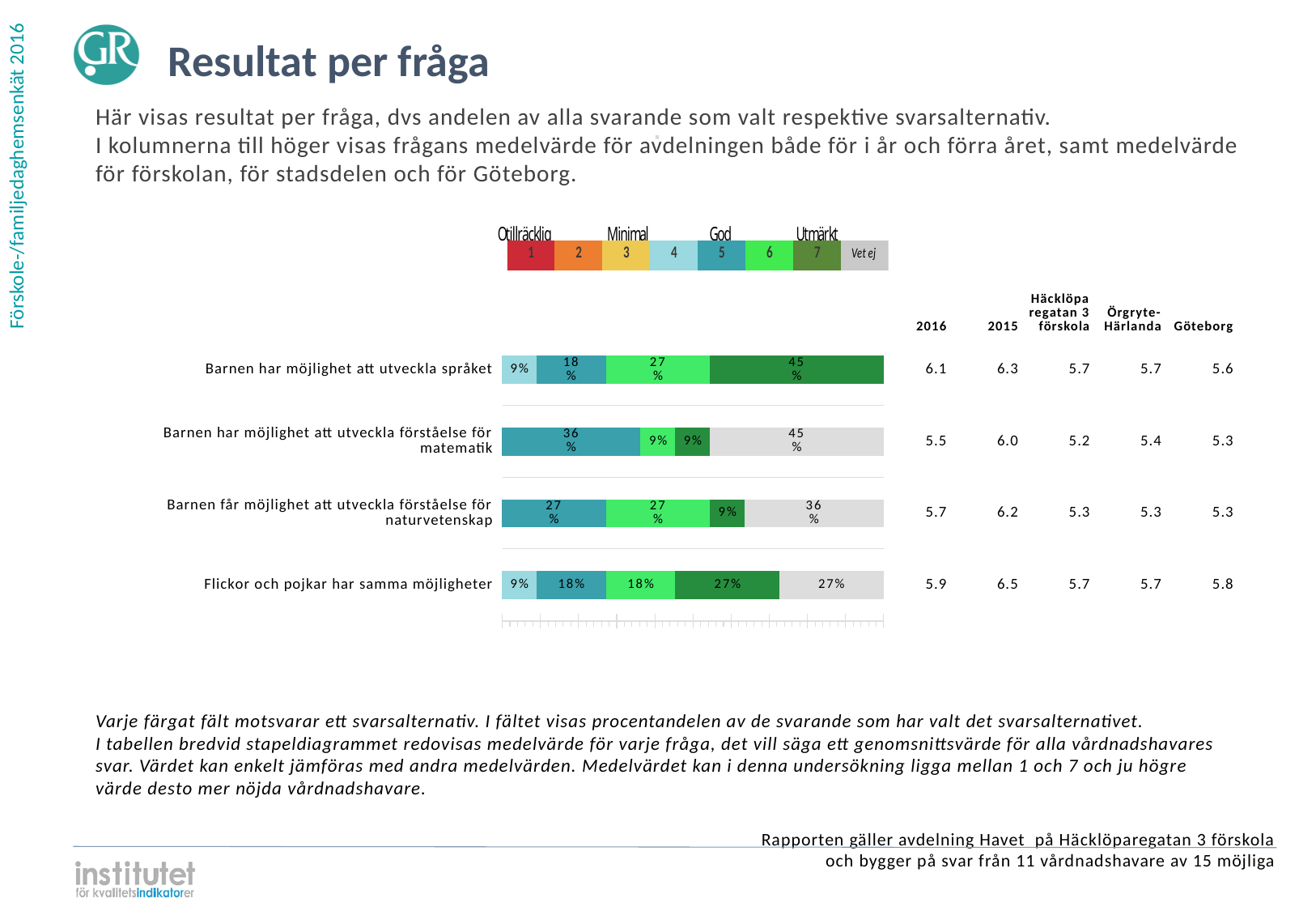
How many answer alternatives does the legend above the chart list? 8 Which is larger: the share choosing 5 for the matematik question or the share choosing 5 for the naturvetenskap question? matematik (36%) What percentage of respondents answered 'Vet ej' for 'Barnen har möjlighet att utveckla förståelse för matematik'? 45% What percentage of respondents chose 7 (Utmärkt) for 'Barnen har möjlighet att utveckla språket'? 45% How many questions (categories) are plotted in the bar chart? 4 What kind of chart is shown on the slide? stacked bar chart What percentage chose 7 for 'Flickor och pojkar har samma möjligheter'? 27% Which question has the largest share of respondents choosing 7 (Utmärkt)? Barnen har möjlighet att utveckla språket What is the 2016 mean value shown for 'Flickor och pojkar har samma möjligheter'? 5.9 What percentage chose 5 for 'Barnen får möjlighet att utveckla förståelse för naturvetenskap'? 27% What is the difference between the 'Vet ej' share for the matematik question and the 'Vet ej' share for the naturvetenskap question? 9 percentage points What label does the legend give to answer alternative 7? Utmärkt